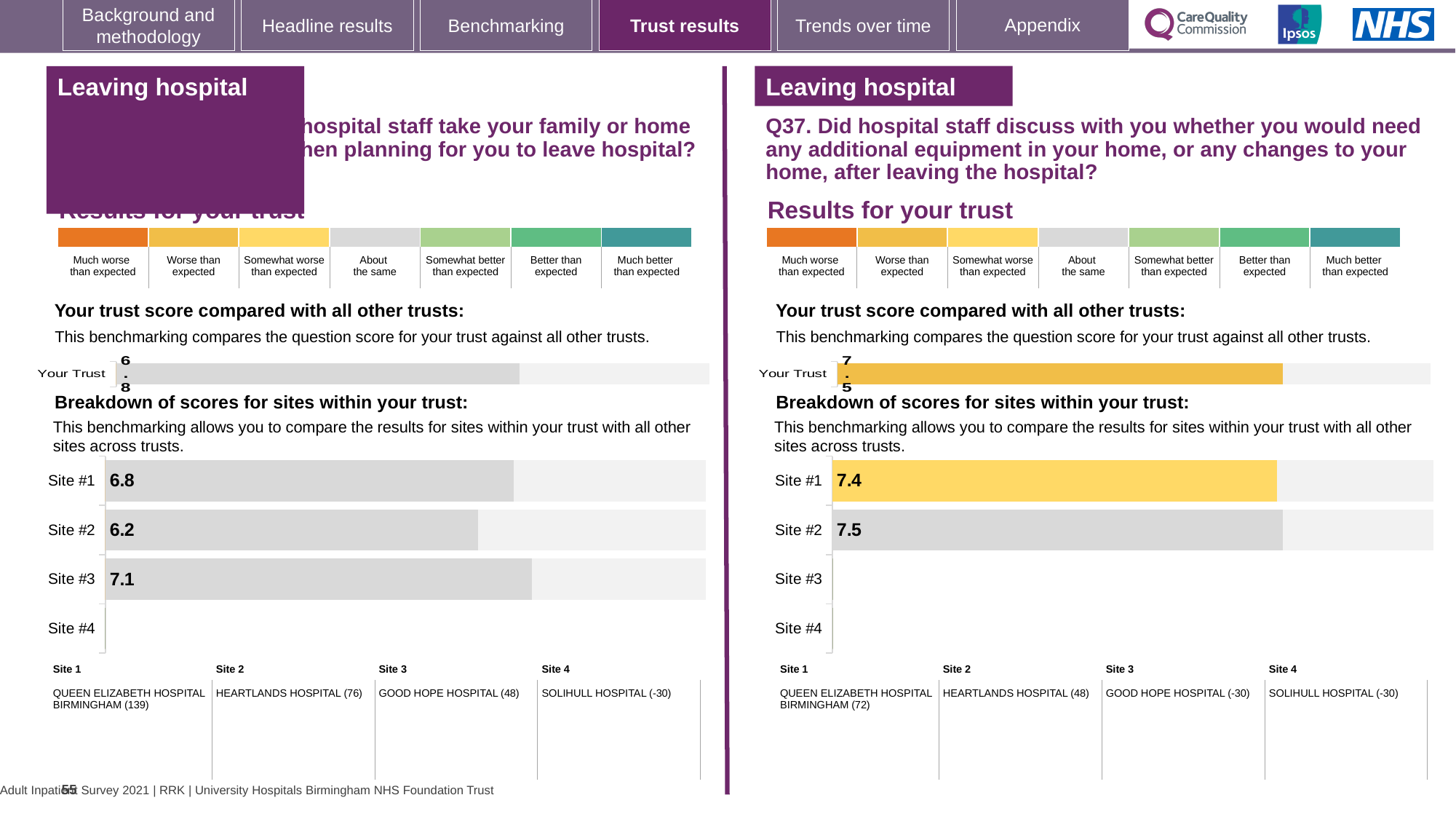
On the left chart (breakdown of scores for sites), what is the difference between the scores for Site #3 and Site #2? 0.9 What kind of chart is used for the breakdown of scores for sites on the right panel for Q37? Bar chart On the right chart for Q37 (breakdown of scores for sites), how many sites have a score bar plotted? 2 On the right chart for Q37 (breakdown of scores for sites), what is the score for Site #2? 7.5 On the right chart for Q37 (breakdown of scores for sites), what is the score for Site #1? 7.4 On the left panel, what is the 'Your Trust' score shown in the trust comparison bar? 6.8 On the right panel for Q37, what is the 'Your Trust' score shown in the trust comparison bar? 7.5 On the right chart for Q37 (breakdown of scores for sites), which is larger, the score for Site #1 or Site #2? Site #2 On the left chart (breakdown of scores for sites), what is the score for Site #1? 6.8 On the left chart (breakdown of scores for sites), which site has the highest score? Site #3 On the left chart (breakdown of scores for sites), which site has the lowest score? Site #2 On the left chart (breakdown of scores for sites), what is the score for Site #3? 7.1